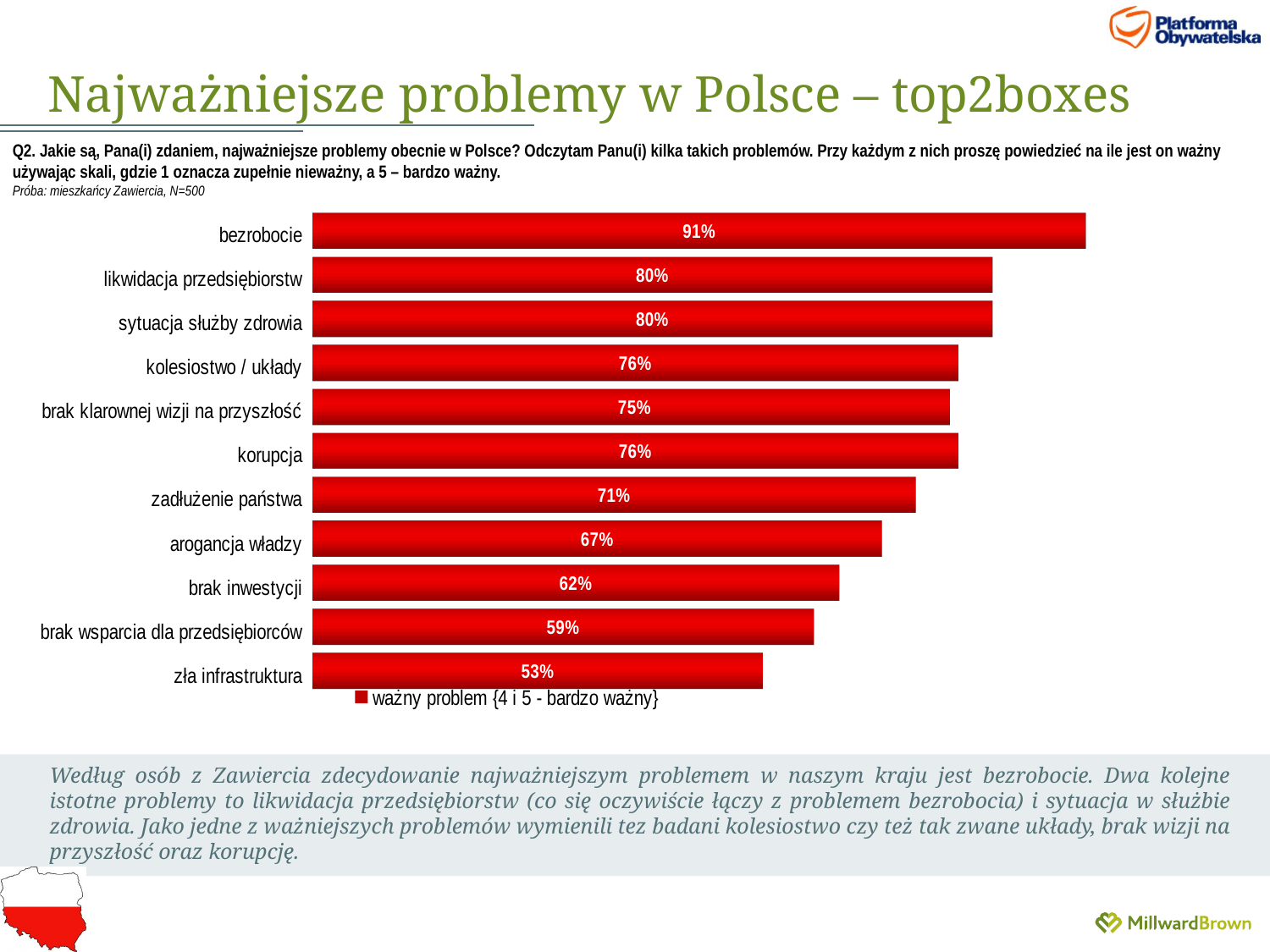
What is the legend entry of the chart? ważny problem {4 i 5 - bardzo ważny} What is the value for bezrobocie? 91% What is the value for brak wsparcia dla przedsiębiorców? 59% What kind of chart is shown on the slide? bar chart What is the difference between the values for arogancja władzy and brak inwestycji? 5% Which category has the lowest value? zła infrastruktura Which category has the highest value? bezrobocie What is the difference between the values for bezrobocie and zła infrastruktura? 38% How many categories are shown in the chart? 11 Which is larger, the value for korupcja or the value for zadłużenie państwa? korupcja Which is larger, the value for brak inwestycji or the value for brak wsparcia dla przedsiębiorców? brak inwestycji What is the value for zadłużenie państwa? 71%